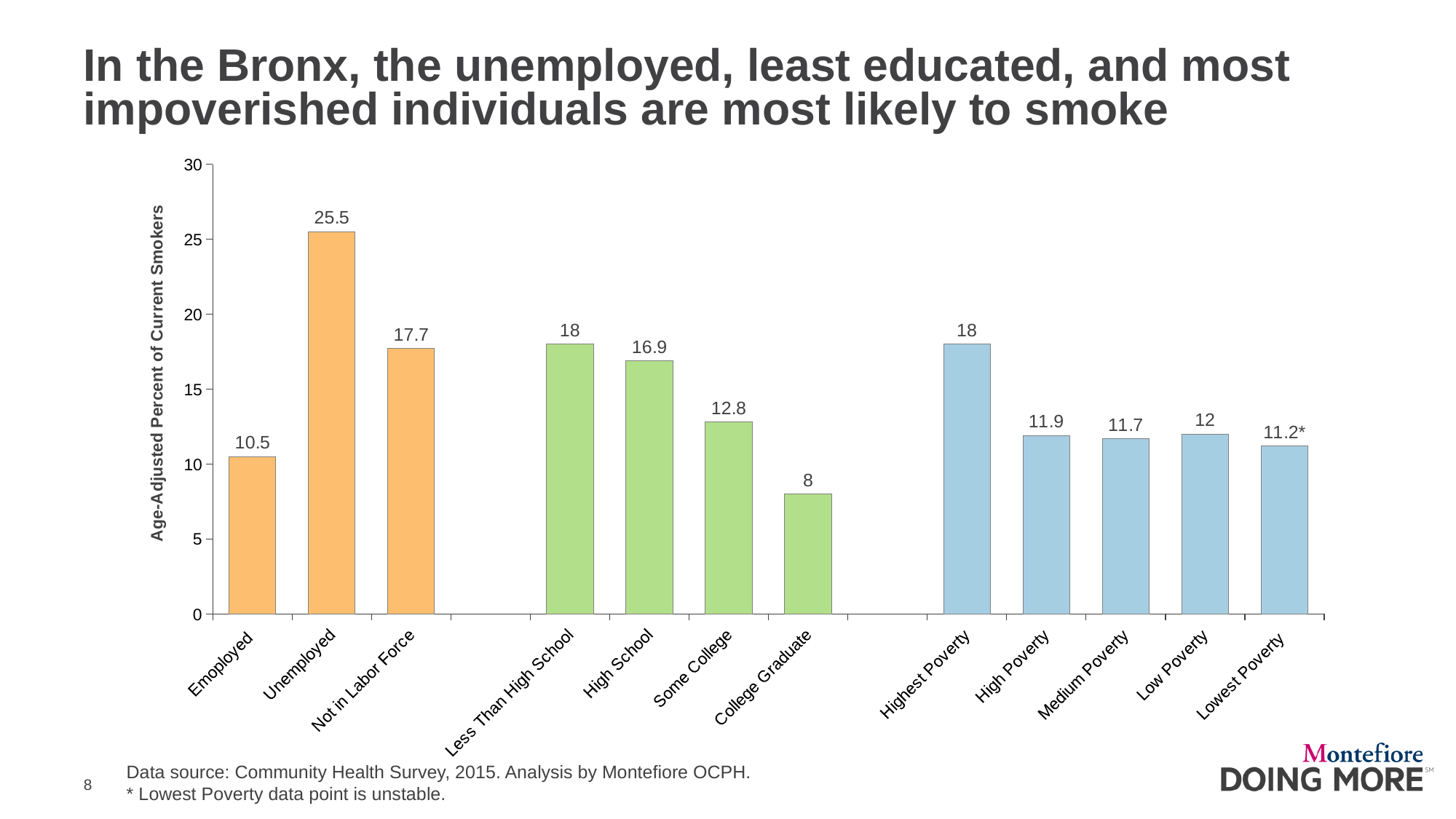
How many categories are plotted on the chart? 12 What is the difference between the values for Less Than High School and High School? 1.1 Is the value for Highest Poverty greater or less than 15? greater What kind of chart is shown on the slide? Bar chart What is the age-adjusted percent of current smokers for the Unemployed category? 25.5 Which category has the highest percent of current smokers? Unemployed What is the difference between the values for Unemployed and Employed? 15 What is the label of the vertical axis? Age-Adjusted Percent of Current Smokers What is the value shown for College Graduate? 8 Which has a higher value, Not in Labor Force or Some College? Not in Labor Force What is the value shown for Medium Poverty? 11.7 Which category has the lowest percent of current smokers? College Graduate